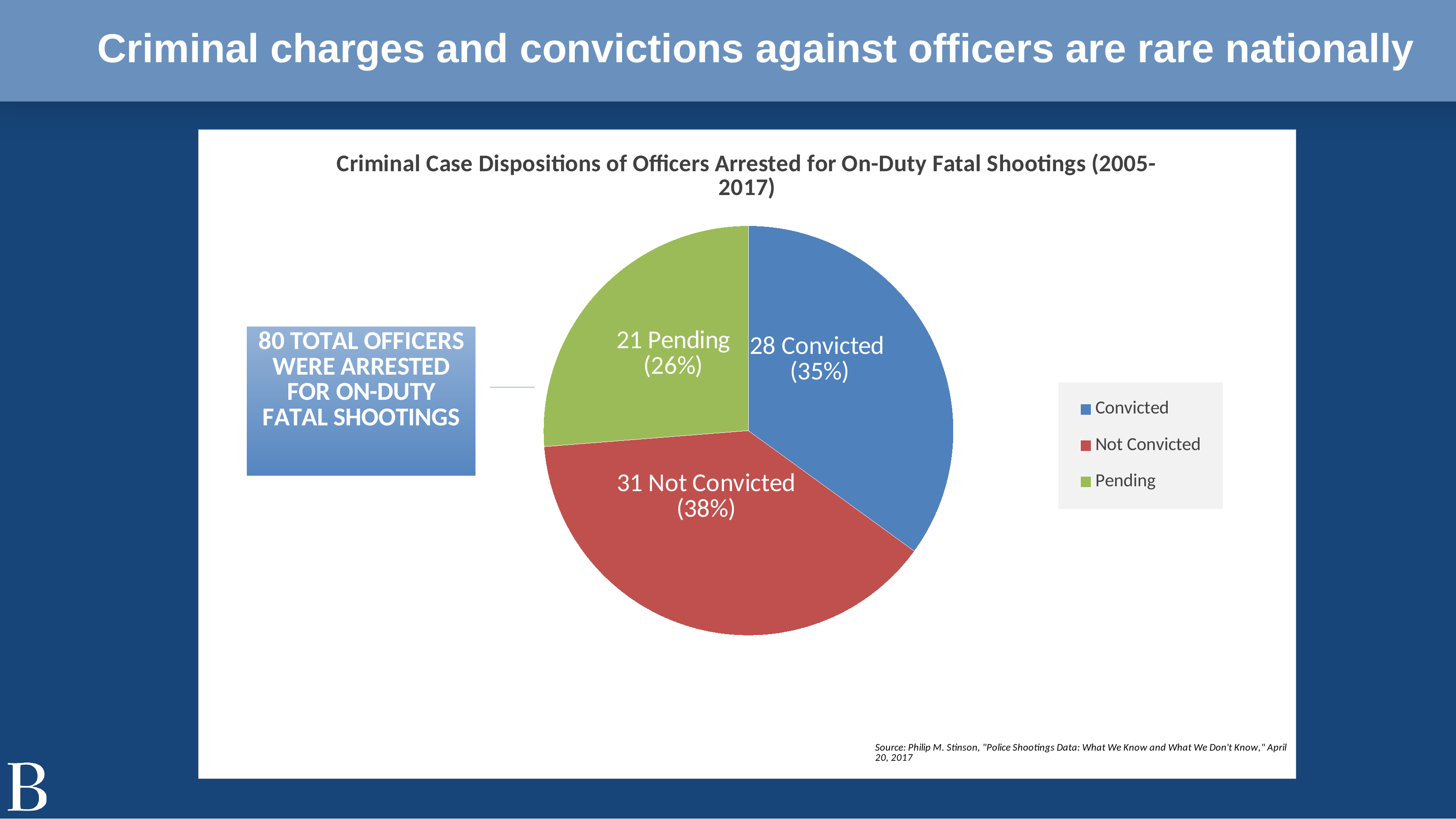
What share of the pie does the Pending slice represent? 26% Which category has the smallest slice? Pending What is the title of the chart? Criminal Case Dispositions of Officers Arrested for On-Duty Fatal Shootings (2005-2017) Which category has the largest slice? Not Convicted How many officers were not convicted? 31 What kind of chart is shown on the slide? pie chart What is the difference between the number of officers not convicted and the number convicted? 3 How many officers were convicted? 28 How many categories does the pie chart have? 3 Which is larger, the number convicted or the number pending? Convicted What share of the pie does the Not Convicted slice represent? 38% How many cases are pending? 21